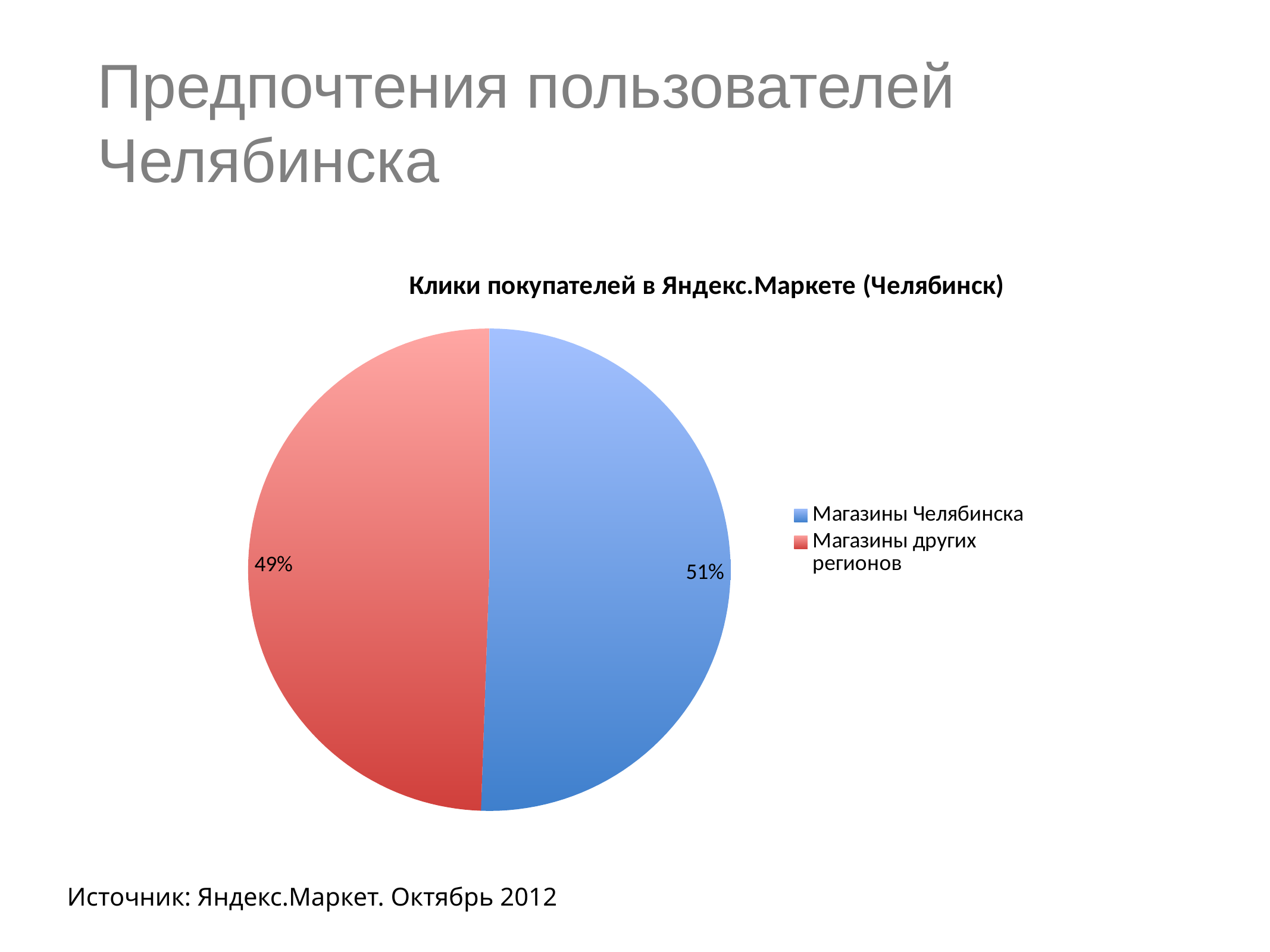
What share of the pie does Магазины Челябинска have? 51% Which is larger: the share of Магазины Челябинска or the share of Магазины других регионов? Магазины Челябинска What share of the pie does Магазины других регионов have? 49% Which category has the smallest share of the pie? Магазины других регионов What kind of chart is shown on the slide? Pie chart How many entries does the legend list? 2 What colour is the slice for Магазины других регионов? Red What is the difference between the shares of Магазины Челябинска and Магазины других регионов? 2% What is the title of the chart? Клики покупателей в Яндекс.Маркете (Челябинск) How many slices does the pie chart have? 2 Which category has the largest share of the pie? Магазины Челябинска